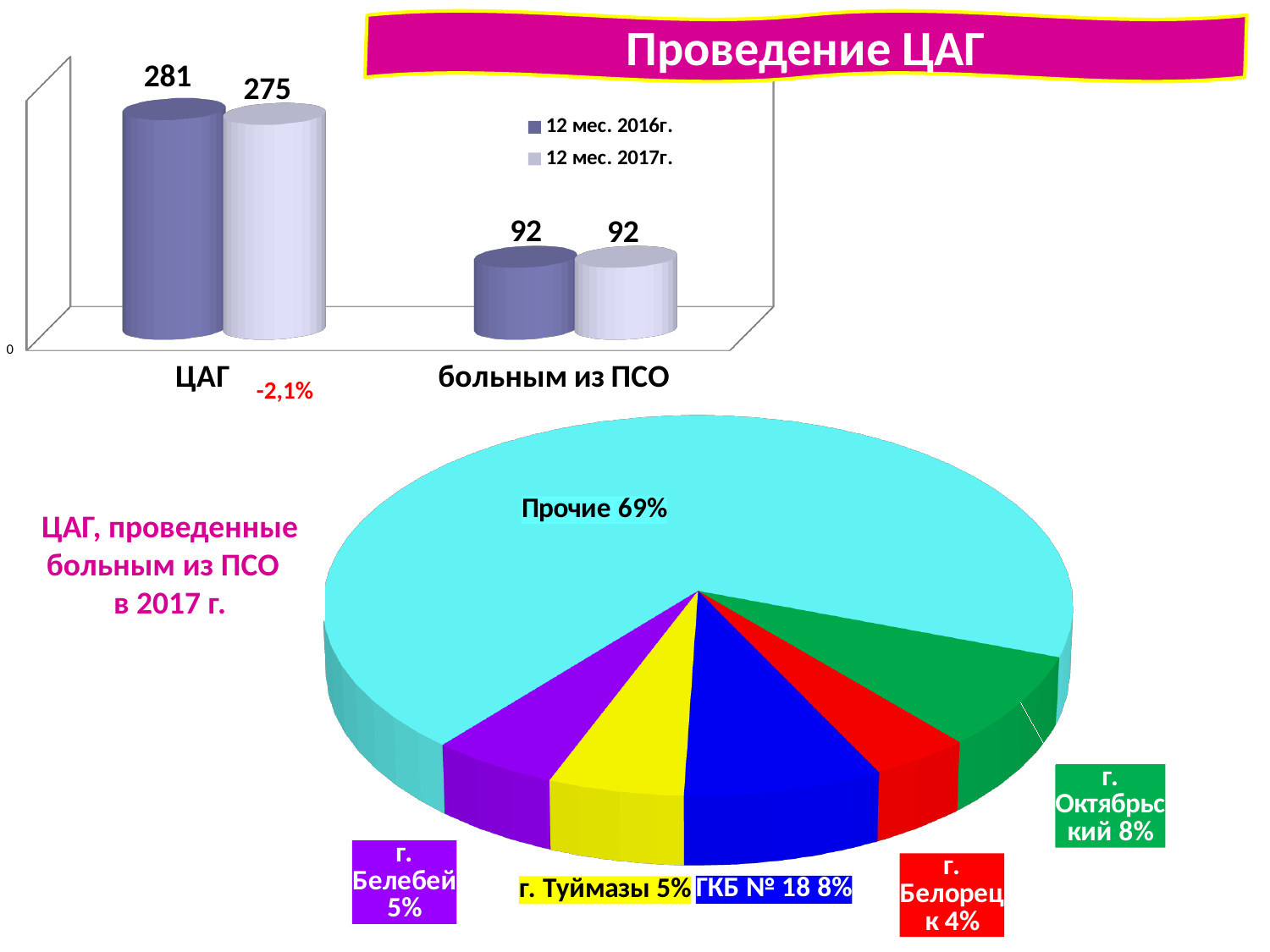
In the bar chart 'Проведение ЦАГ', what is the difference between the ЦАГ values for 12 мес. 2016г. and 12 мес. 2017г.? 6 In the bar chart 'Проведение ЦАГ', how many series does the legend list? 2 In the pie chart 'ЦАГ, проведенные больным из ПСО в 2017 г.', what share does Прочие have? 69% In the bar chart 'Проведение ЦАГ', how many categories are shown on the x axis? 2 In the pie chart 'ЦАГ, проведенные больным из ПСО в 2017 г.', which slice is the smallest? г. Белорецк In the bar chart 'Проведение ЦАГ', which is larger for ЦАГ: the 12 мес. 2016г. value or the 12 мес. 2017г. value? 12 мес. 2016г. In the bar chart 'Проведение ЦАГ', what is the value for ЦАГ in 12 мес. 2016г.? 281 What kind of chart is the top chart 'Проведение ЦАГ'? bar chart In the pie chart 'ЦАГ, проведенные больным из ПСО в 2017 г.', how many slices are there? 6 In the pie chart 'ЦАГ, проведенные больным из ПСО в 2017 г.', what share does г. Белорецк have? 4% In the bar chart 'Проведение ЦАГ', what is the value for больным из ПСО in 12 мес. 2017г.? 92 In the bar chart 'Проведение ЦАГ', what is the value for ЦАГ in 12 мес. 2017г.? 275